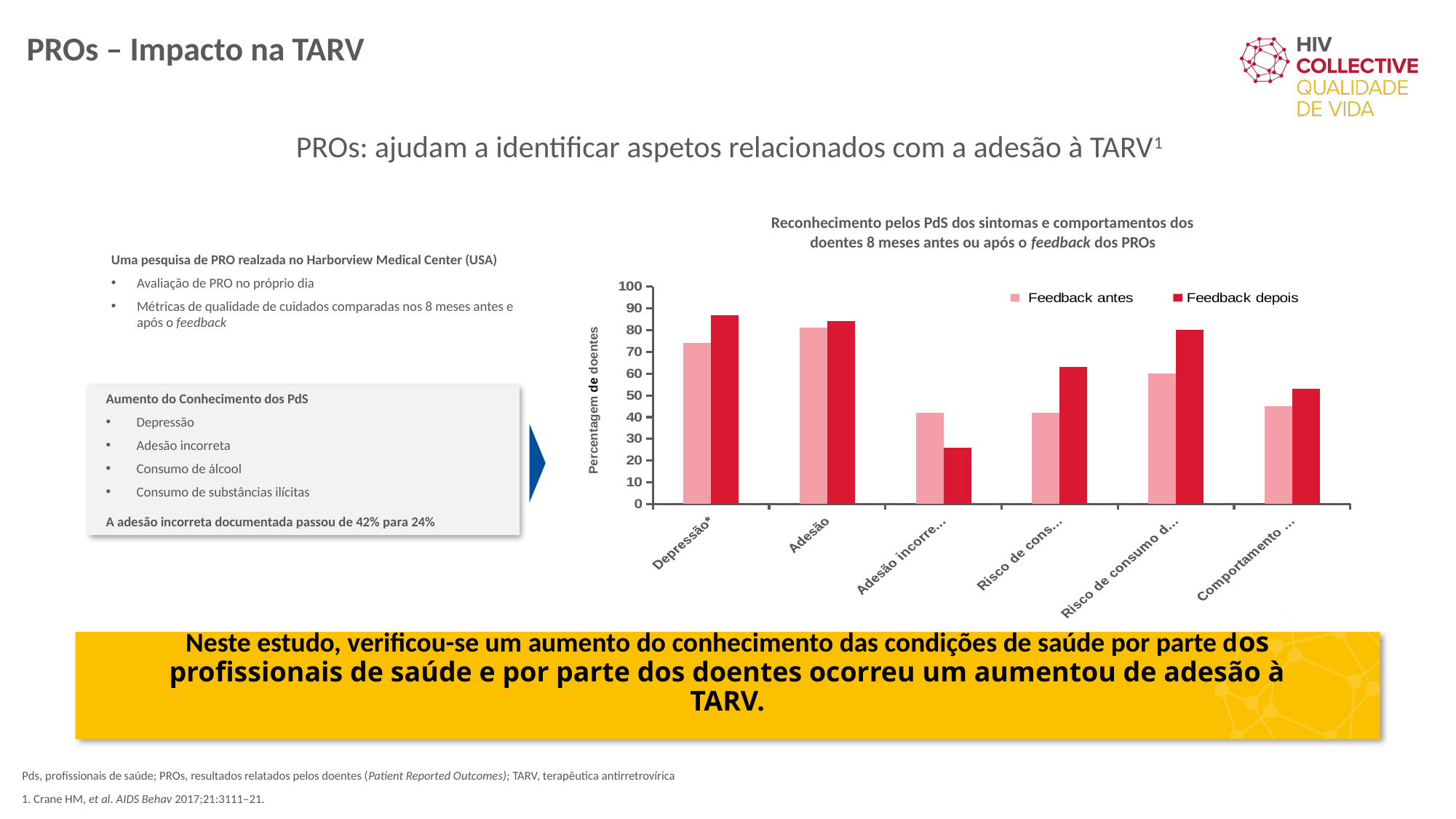
Is the 'Feedback antes' value for Depressão* greater or less than 80? less Is the 'Feedback antes' value for Adesão greater or less than 70? greater How many categories are shown along the x axis of the chart? 6 Is the 'Feedback depois' value for Depressão* greater or less than 80? greater What type of chart is shown on the slide? bar chart Which category has the highest 'Feedback depois' value? Depressão* What is the label of the y axis of the chart? Percentagem de doentes What are the two series named in the chart legend? Feedback antes, Feedback depois For the third category (Adesão incorreta), which is larger: 'Feedback antes' or 'Feedback depois'? Feedback antes How many series does the chart legend list? 2 For Depressão*, which is larger: 'Feedback antes' or 'Feedback depois'? Feedback depois